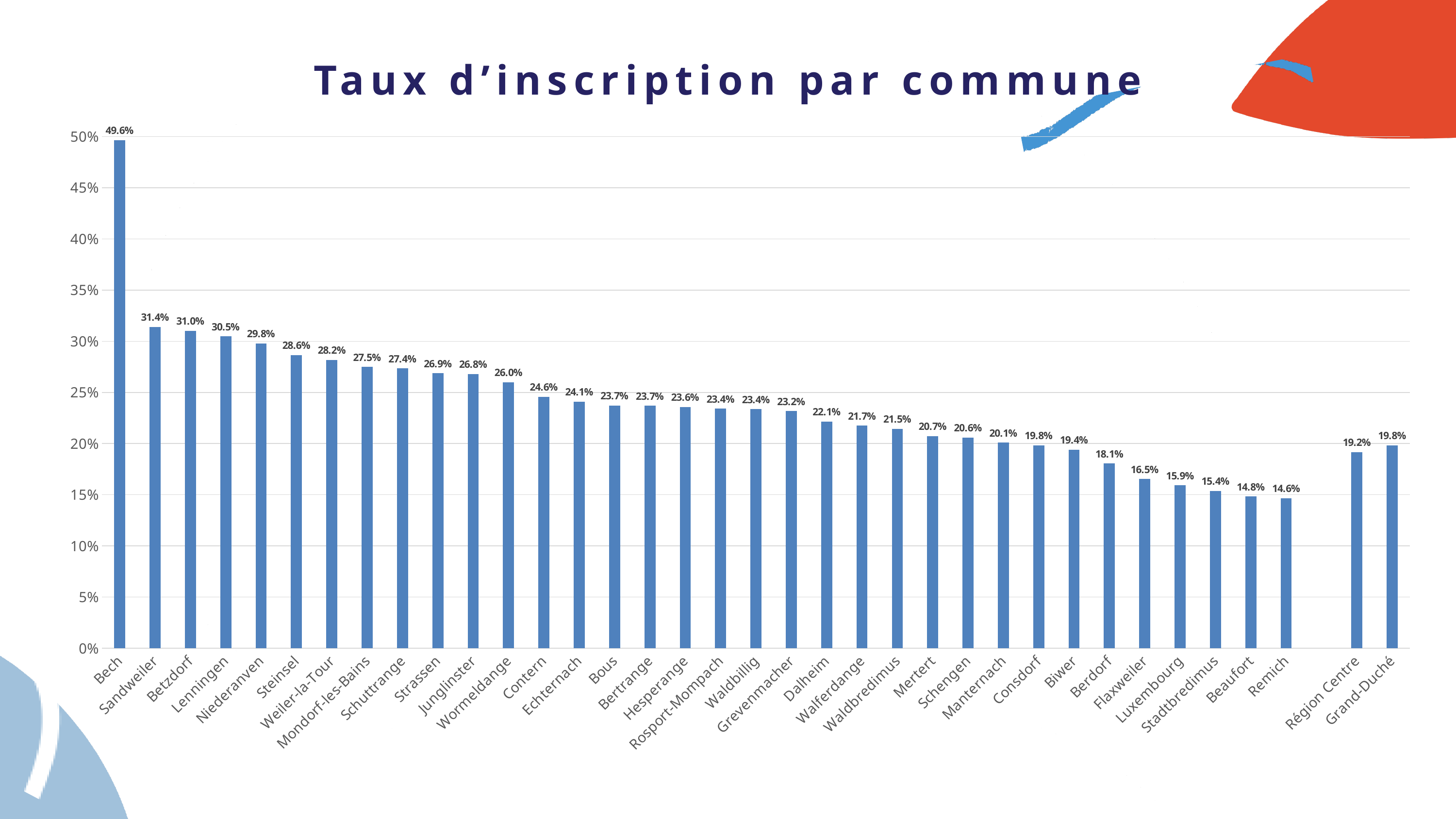
Which is larger, the value for Steinsel or the value for Contern? Steinsel What kind of chart is shown on the slide? bar chart What is the value for Grand-Duché? 19.8% What is the difference between the values for Bech and Sandweiler? 18.2% How many bars are shown in the chart? 36 Is the value for Berdorf greater or less than 20%? less What is the value for Luxembourg? 15.9% What is the title of the chart? Taux d'inscription par commune Which category has the lowest value? Remich Which commune has the highest value? Bech What is the value for Bech? 49.6% What is the value for Région Centre? 19.2%